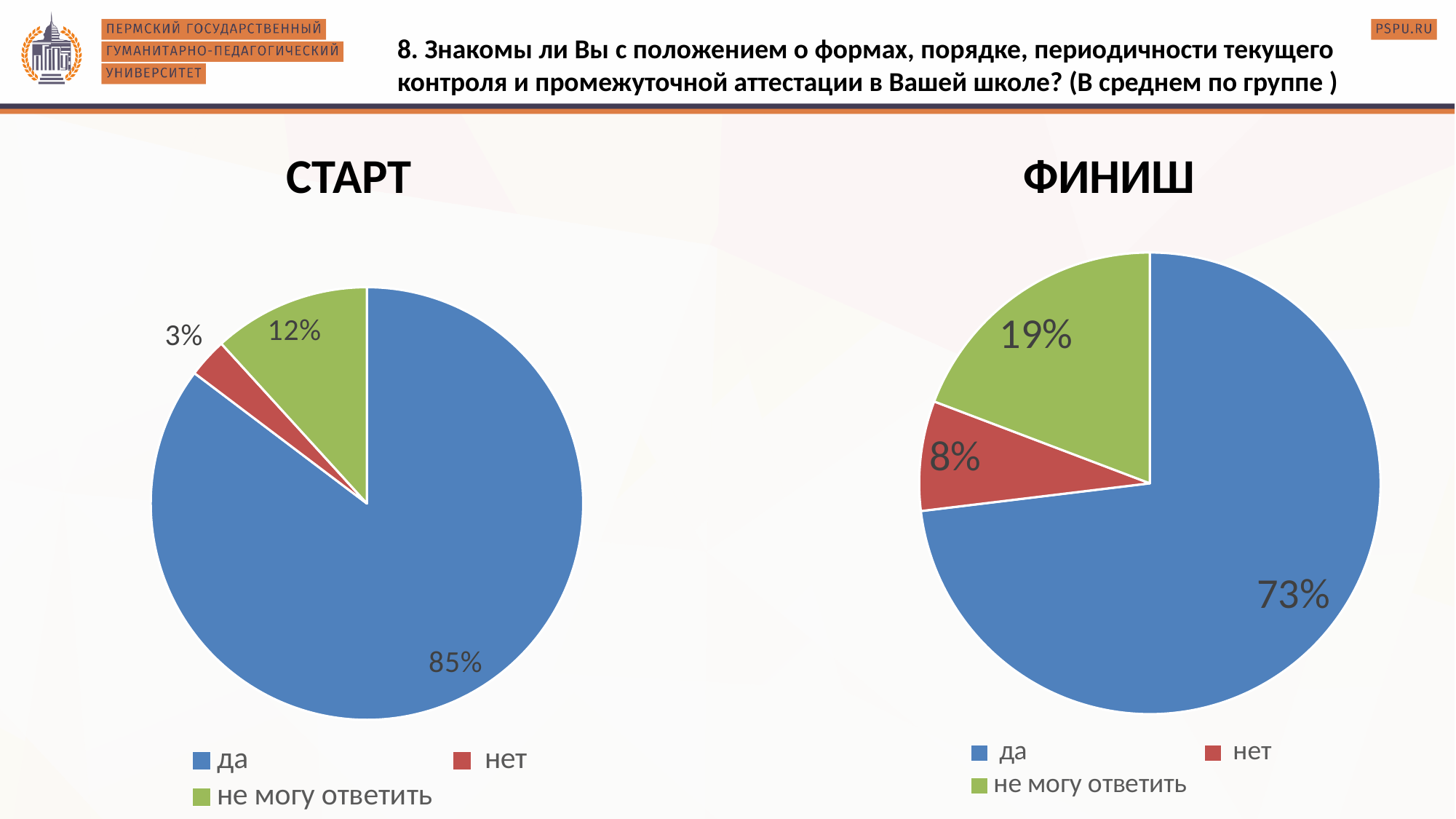
In the ФИНИШ pie chart, what percentage answered "нет"? 8% In the ФИНИШ pie chart, what percentage answered "да"? 73% In the СТАРТ pie chart, what percentage answered "не могу ответить"? 12% Which is larger: the "нет" share in the СТАРТ chart or the "нет" share in the ФИНИШ chart? ФИНИШ In the ФИНИШ pie chart, which answer has the largest share? да In the ФИНИШ chart legend, which colour represents "не могу ответить"? Green In the СТАРТ pie chart, what percentage answered "да"? 85% What is the difference between the "да" share in the СТАРТ chart and the "да" share in the ФИНИШ chart? 12% In the ФИНИШ pie chart, what is the difference between the "не могу ответить" share and the "нет" share? 11% How many slices does the СТАРТ pie chart have? 3 In the СТАРТ pie chart, which answer has the smallest share? нет What type of chart is used for the ФИНИШ data? Pie chart